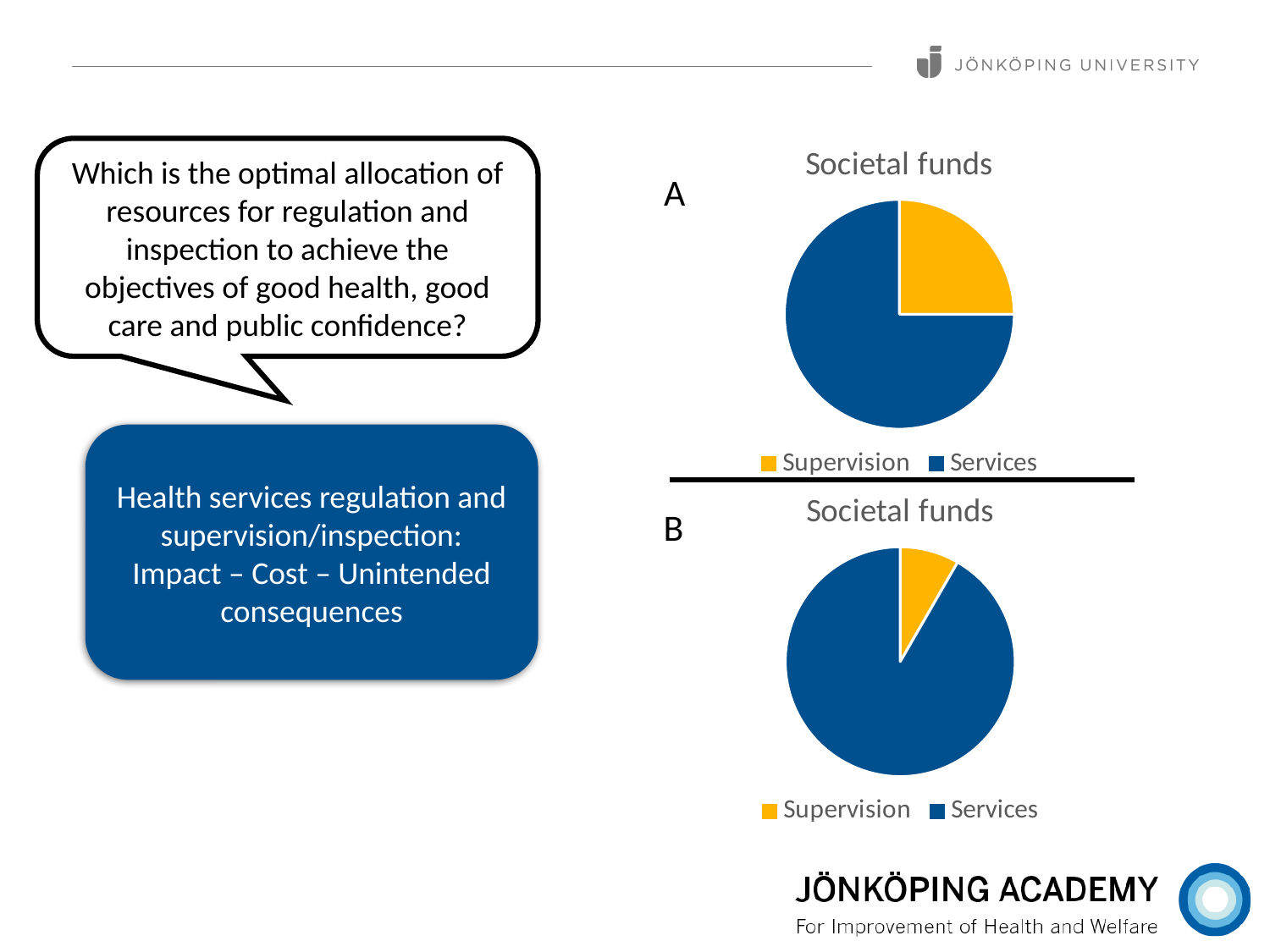
How many slices does chart B (the bottom chart) have? 2 What kind of chart is chart A (the top chart)? pie chart What is the title of chart A (the top chart)? Societal funds In chart A (the top chart), which colour represents Supervision? yellow How many categories does the legend of chart A (the top chart) list? 2 In chart A (the top chart), which category has the largest slice? Services In chart A (the top chart), which category has the smallest slice? Supervision Which chart has the larger Supervision slice, chart A (top) or chart B (bottom)? chart A In chart B (the bottom chart), which category has the smallest slice? Supervision In chart B (the bottom chart), which is larger: the Supervision slice or the Services slice? Services In chart B (the bottom chart), which category has the largest slice? Services What kind of chart is chart B (the bottom chart)? pie chart